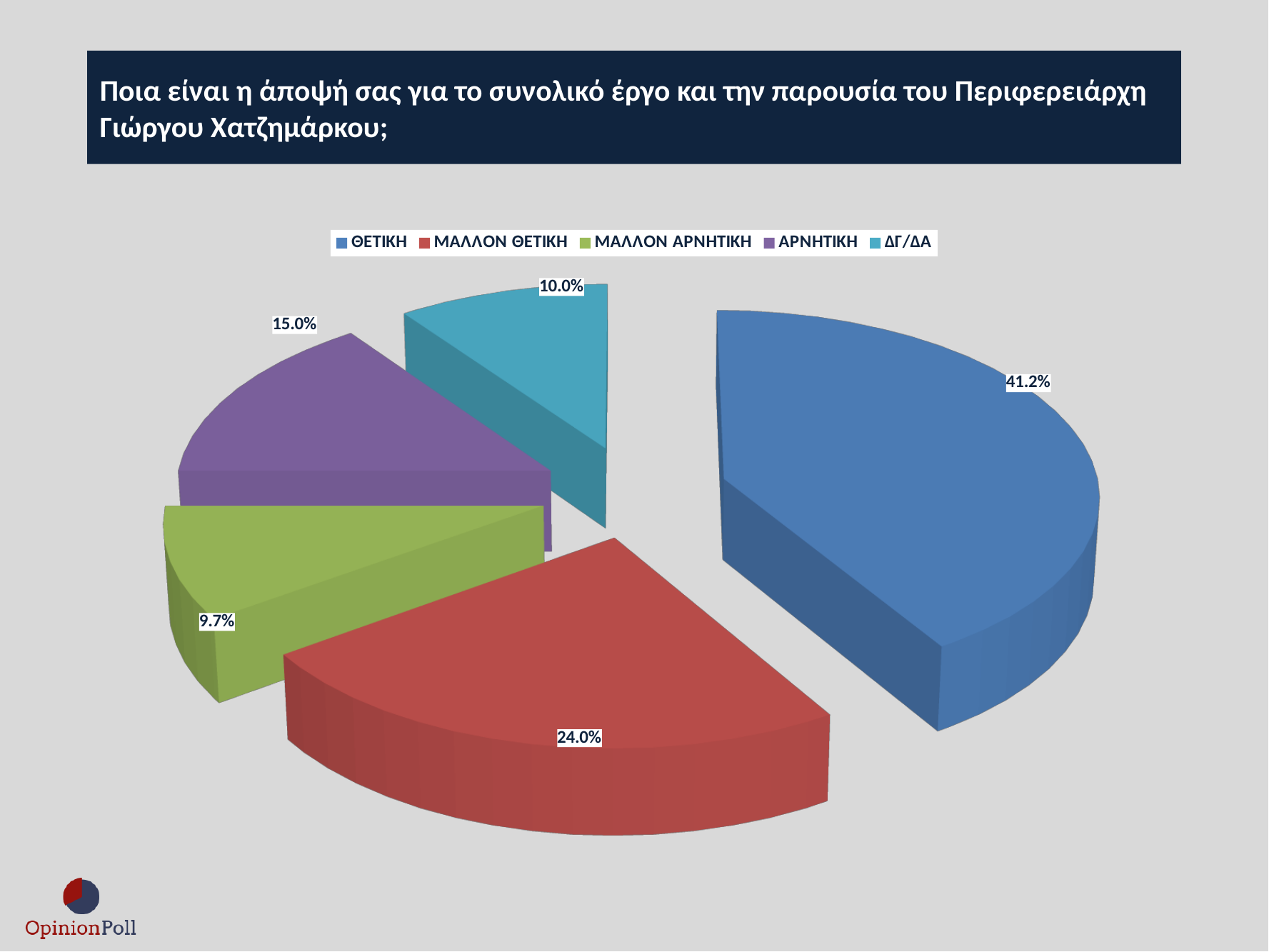
What percentage of respondents answered ΔΓ/ΔΑ? 10.0% Which response category has the smallest share of the pie? ΜΑΛΛΟΝ ΑΡΝΗΤΙΚΗ What percentage of respondents answered ΜΑΛΛΟΝ ΑΡΝΗΤΙΚΗ? 9.7% What type of chart is shown on the slide? Pie chart How many categories does the pie chart show? 5 What percentage of respondents answered ΜΑΛΛΟΝ ΘΕΤΙΚΗ? 24.0% What is the difference in percentage points between ΘΕΤΙΚΗ and ΜΑΛΛΟΝ ΘΕΤΙΚΗ? 17.2 What colour is the slice for ΜΑΛΛΟΝ ΘΕΤΙΚΗ? Red Which is larger, the share for ΑΡΝΗΤΙΚΗ or the share for ΔΓ/ΔΑ? ΑΡΝΗΤΙΚΗ What percentage of respondents answered ΑΡΝΗΤΙΚΗ? 15.0% Which response category has the largest share of the pie? ΘΕΤΙΚΗ What percentage of respondents answered ΘΕΤΙΚΗ? 41.2%